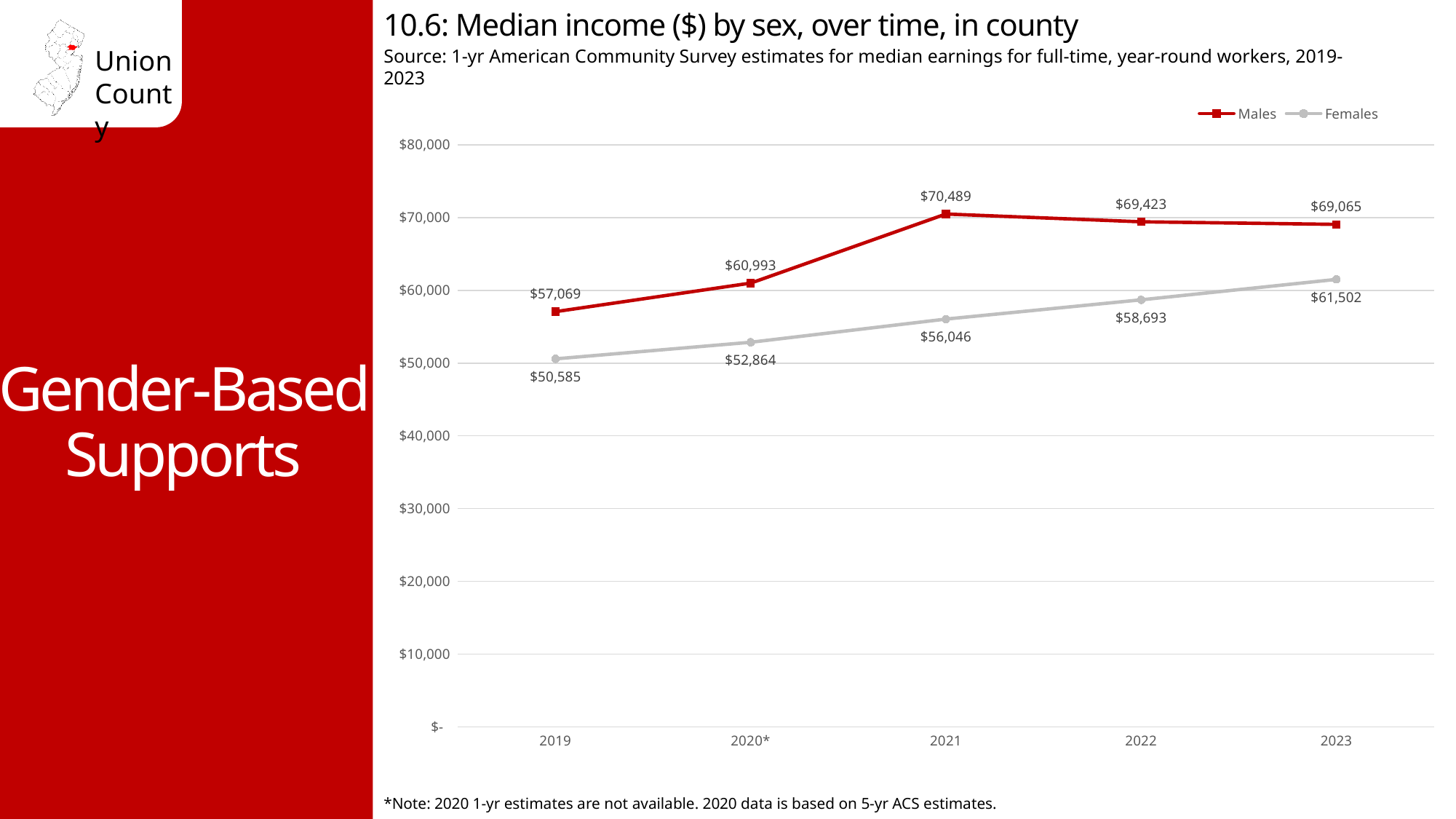
What is the difference between the Males and Females median income in 2023? $7,563 What was the median income for Females in 2019? $50,585 Which series had the higher median income in 2020*, Males or Females? Males What was the median income for Females in 2023? $61,502 What was the median income for Males in 2021? $70,489 What kind of chart is shown on the slide? Line chart Is the median income for Males in 2019 greater or less than $60,000? less Does the median income for Females rise or fall from 2019 to 2023? Rise How many years are shown on the x axis? 5 In which year was the median income for Males highest? 2021 In which year was the median income for Females lowest? 2019 How many series does the legend list? 2